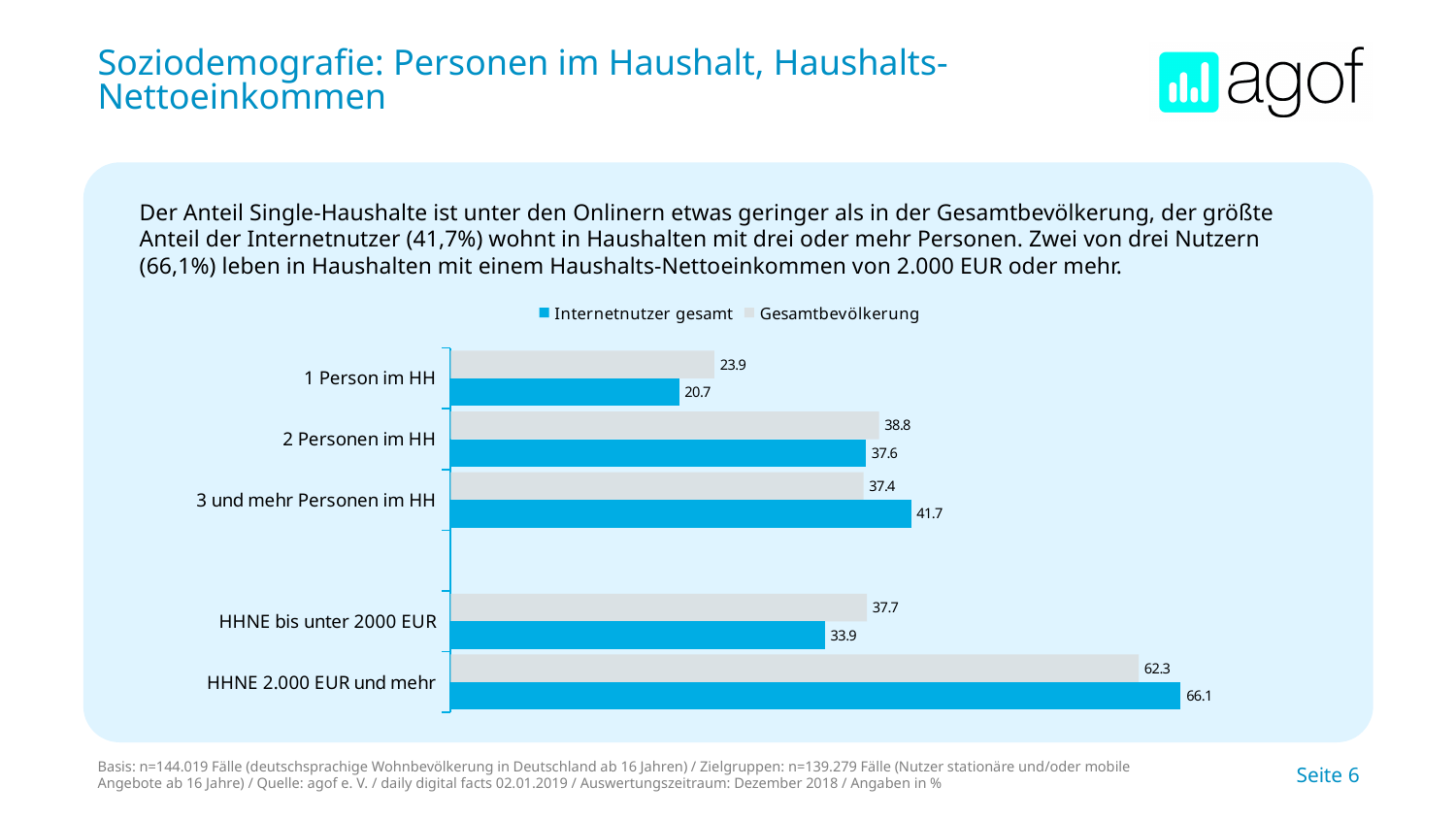
What kind of chart is shown on the slide? Bar chart What is the value for Gesamtbevölkerung in the category 'HHNE 2.000 EUR und mehr'? 62.3 What is the difference between Internetnutzer gesamt and Gesamtbevölkerung in the category 'HHNE 2.000 EUR und mehr'? 3.8 How many categories are shown on the chart? 5 How many series does the legend list? 2 What is the value for Internetnutzer gesamt in the category '3 und mehr Personen im HH'? 41.7 Which category has the lowest value for Gesamtbevölkerung? 1 Person im HH What is the value for Internetnutzer gesamt in the category 'HHNE bis unter 2000 EUR'? 33.9 In the category '2 Personen im HH', which series has the larger value, Internetnutzer gesamt or Gesamtbevölkerung? Gesamtbevölkerung Which series is shown in blue in the legend? Internetnutzer gesamt Which category has the highest value for Internetnutzer gesamt? HHNE 2.000 EUR und mehr What is the value for Gesamtbevölkerung in the category '1 Person im HH'? 23.9